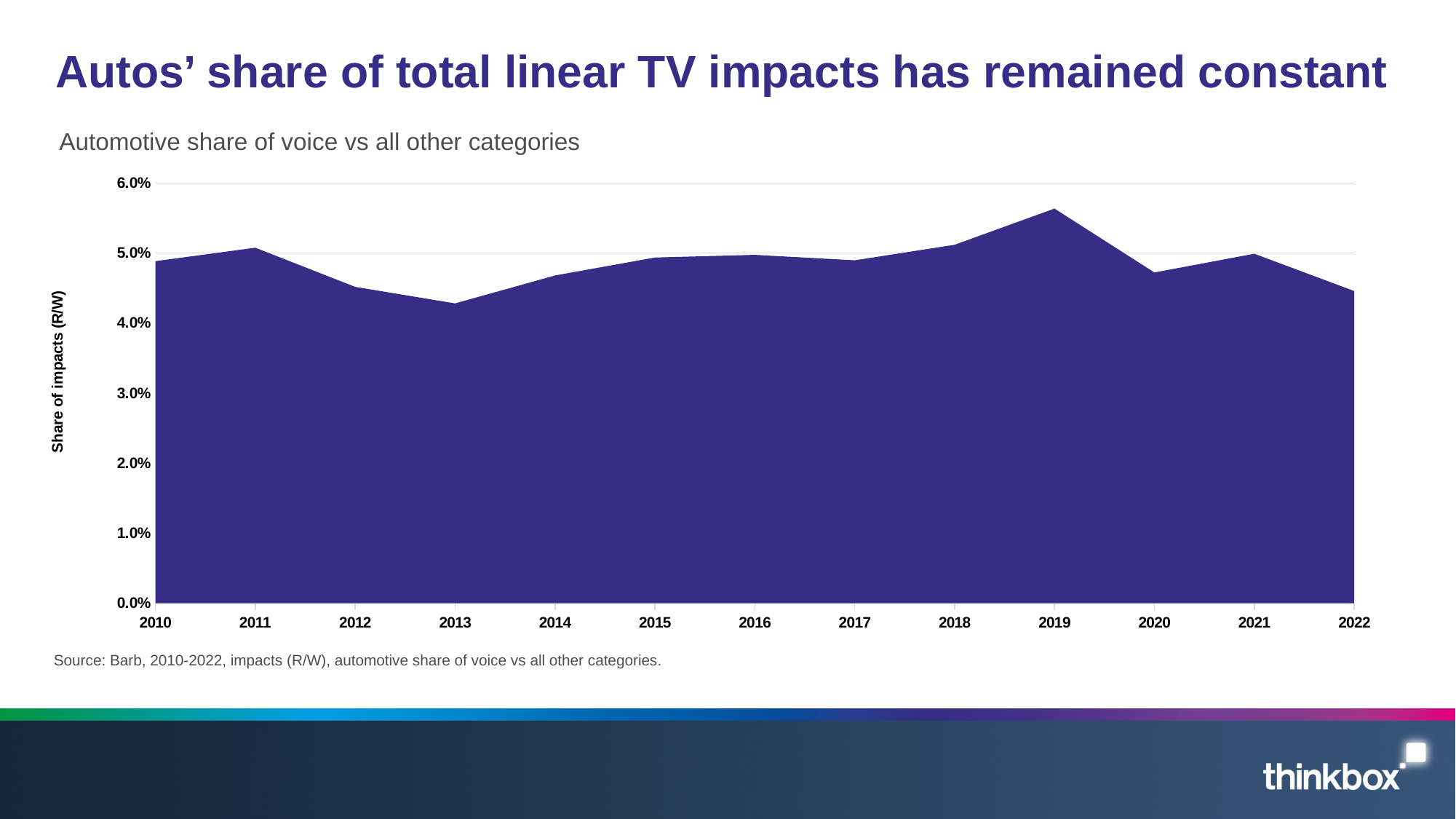
How many years are plotted along the x axis? 13 Is the value for 2016 greater or less than 4.0%? greater Which year has the lowest automotive share of impacts? 2013 What kind of chart is shown on the slide? Area chart Is the value for 2013 greater or less than 5.0%? less Is the value for 2022 greater or less than 5.0%? less Which is larger, the value for 2018 or the value for 2020? 2018 Which is larger, the value for 2011 or the value for 2012? 2011 Which year has the highest automotive share of impacts? 2019 What is the label on the y axis of the chart? Share of impacts (R/W) Does the automotive share rise or fall from 2017 to 2019? rise